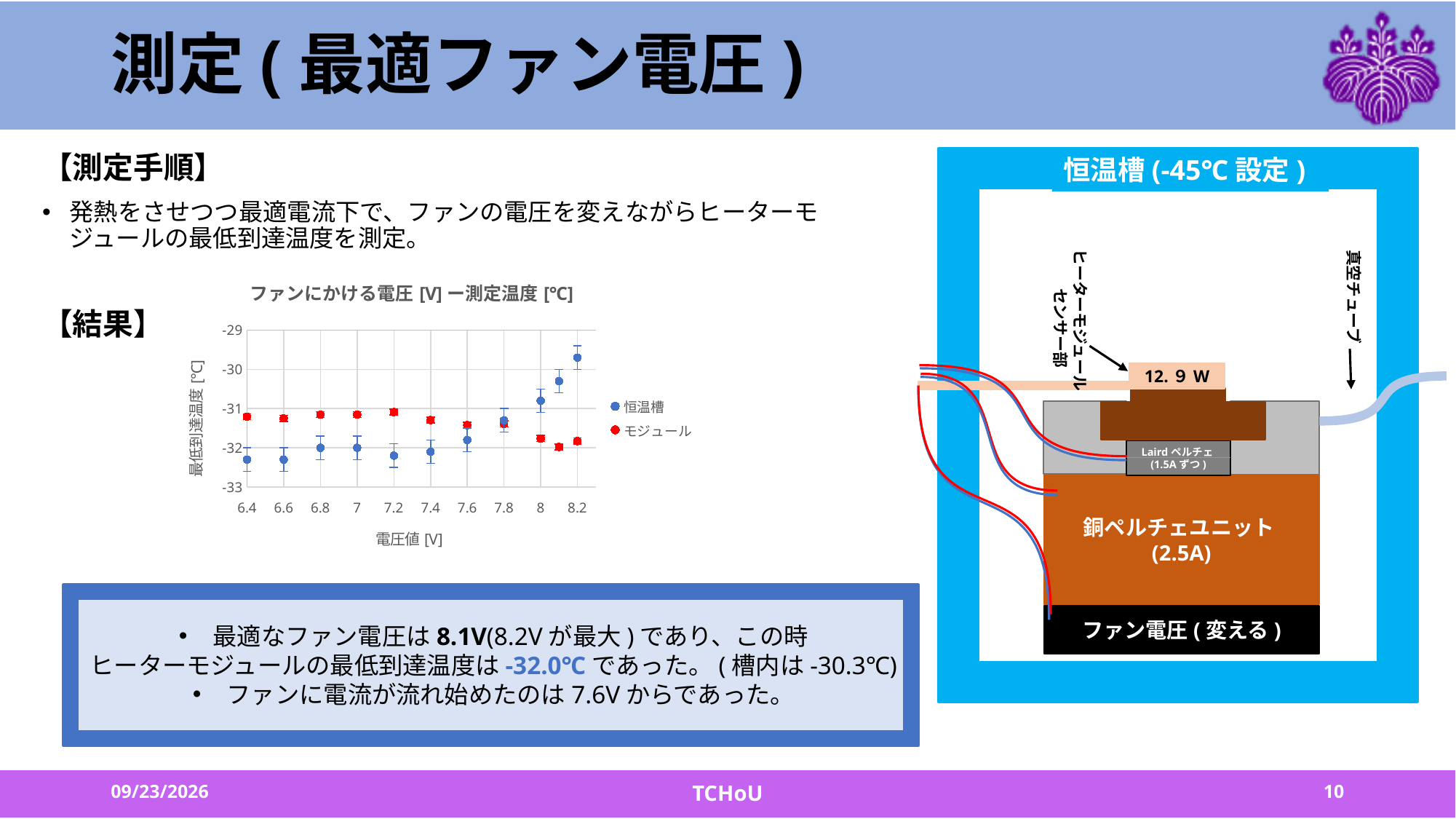
How many series does the chart legend list? 2 Is the 恒温槽 value at 6.4 V greater or less than -32? less What is the title of the chart? ファンにかける電圧 [V] ー測定温度 [℃] What kind of chart is shown on the slide? scatter chart Is the 恒温槽 value at 8.2 V greater or less than -30? greater At 8.2 V, which series has the higher value, 恒温槽 or モジュール? 恒温槽 Is the モジュール value at 6.4 V greater or less than -32? greater What are the two series named in the chart legend? 恒温槽 and モジュール At which voltage is the 恒温槽 series highest? 8.2 Does the 恒温槽 series rise or fall from 7.6 V to 8.2 V? rise At 6.4 V, which series has the higher value, 恒温槽 or モジュール? モジュール